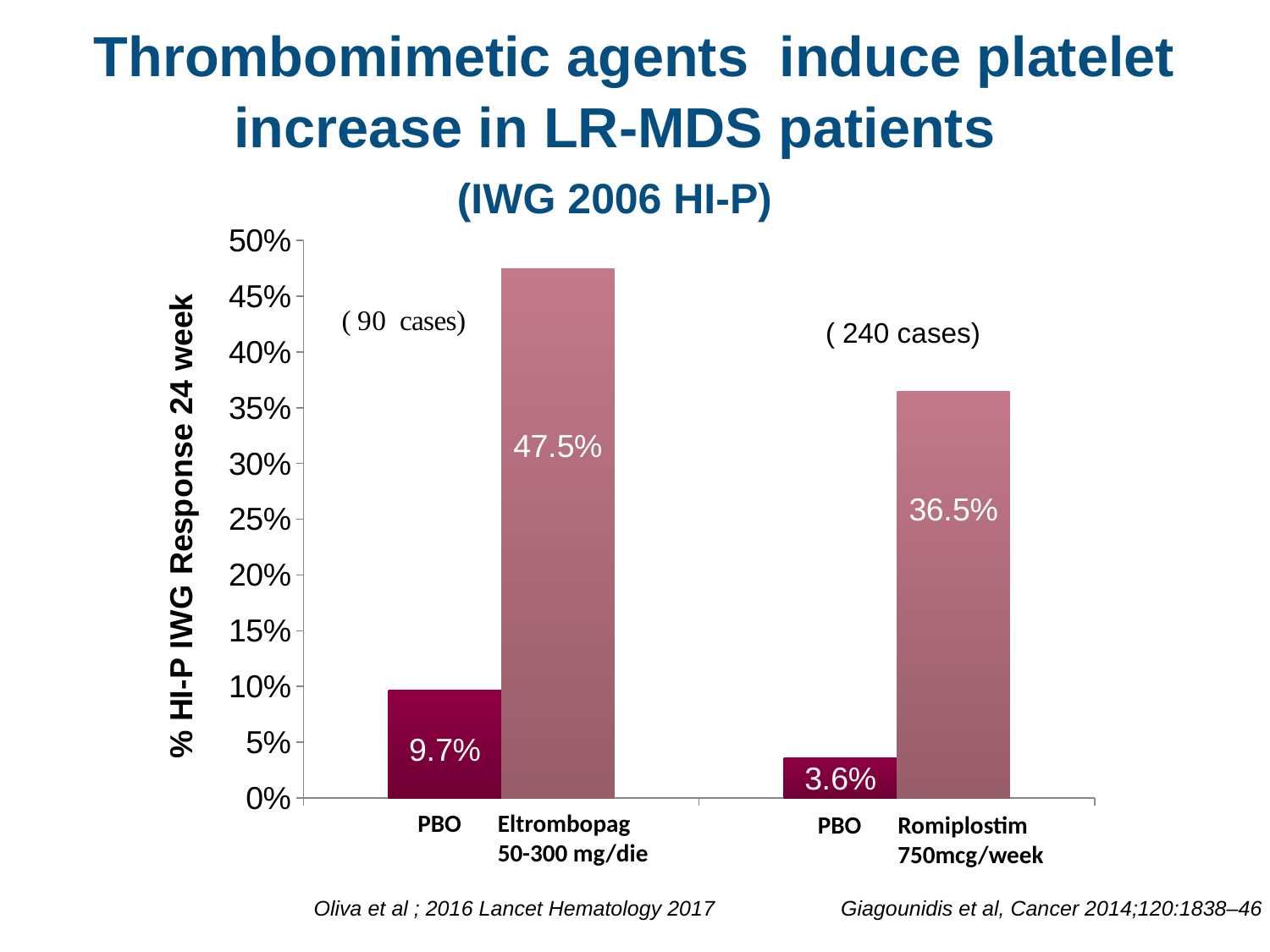
What kind of chart is shown on the slide? bar chart What is the value for Romiplostim 750mcg/week? 36.5% Is the value for Romiplostim 750mcg/week greater or less than 40%? less Which is larger, the value for Eltrombopag or the value for Romiplostim? Eltrombopag What is the difference between the Romiplostim value and its PBO value? 32.9% What is the value for the PBO bar next to Eltrombopag? 9.7% What is the difference between the Eltrombopag value and its PBO value? 37.8% Which bar has the highest value? Eltrombopag 50-300 mg/die What is the value for the PBO bar next to Romiplostim? 3.6% What is the value for Eltrombopag 50-300 mg/die? 47.5% What is the label of the vertical axis? % HI-P IWG Response 24 week Which bar has the lowest value? PBO (next to Romiplostim)